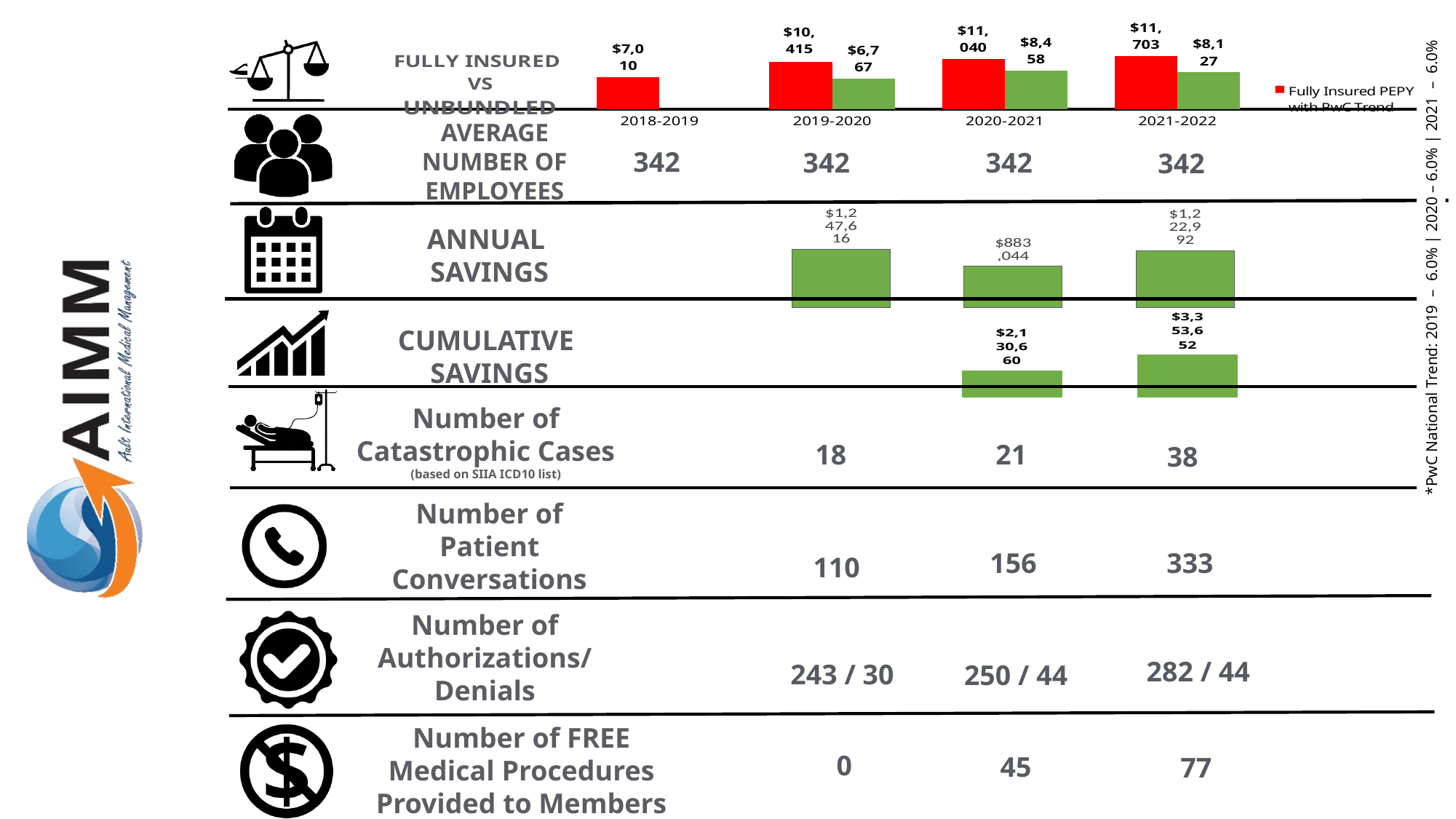
In the 'Cumulative Savings' chart, what is the value for 2021-2022? $3,353,652 How many periods are shown on the x axis of the 'Fully Insured vs Unbundled' chart? 4 In the 'Annual Savings' chart, which is larger: the value for 2019-2020 or the value for 2021-2022? 2019-2020 In the 'Fully Insured vs Unbundled' chart, what is the Fully Insured PEPY value for 2018-2019? $7,010 In the 'Fully Insured vs Unbundled' chart, which period has the highest Fully Insured PEPY value? 2021-2022 In the 'Fully Insured vs Unbundled' chart, what is the difference between the red bar and the green bar for 2020-2021? $2,582 In the 'Fully Insured vs Unbundled' chart, what is the value of the green bar for 2019-2020? $6,767 What kind of chart is the 'Fully Insured vs Unbundled' chart at the top of the slide? bar chart In the 'Fully Insured vs Unbundled' chart, what is the value of the red bar for 2021-2022? $11,703 In the 'Annual Savings' chart, which period has the lowest savings? 2020-2021 In the 'Fully Insured vs Unbundled' chart, do the red bars rise or fall from 2018-2019 to 2021-2022? rise In the 'Annual Savings' chart, what is the value for 2020-2021? $883,044